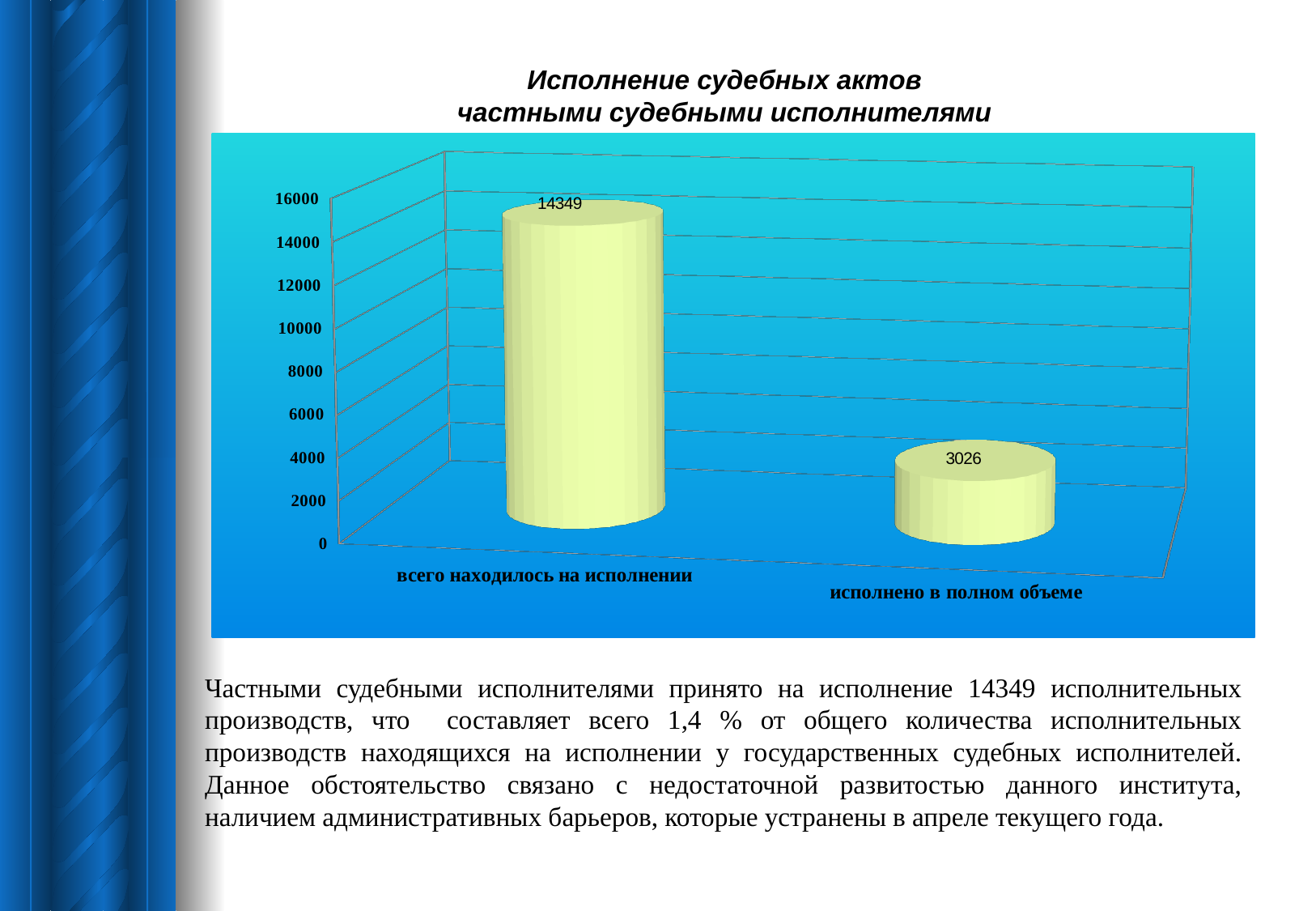
Which is larger: the value for "всего находилось на исполнении" or for "исполнено в полном объеме"? всего находилось на исполнении What is the difference between the values for "всего находилось на исполнении" and "исполнено в полном объеме"? 11323 What is the value for "исполнено в полном объеме"? 3026 How many categories are shown on the chart? 2 What kind of chart is shown on the slide? bar chart What is the maximum value shown on the vertical axis? 16000 What is the value for "всего находилось на исполнении"? 14349 Is the value for "всего находилось на исполнении" greater or less than 12000? greater Which category has the highest value? всего находилось на исполнении What is the title of the chart? Исполнение судебных актов частными судебными исполнителями Is the value for "исполнено в полном объеме" greater or less than 4000? less Which category has the lowest value? исполнено в полном объеме